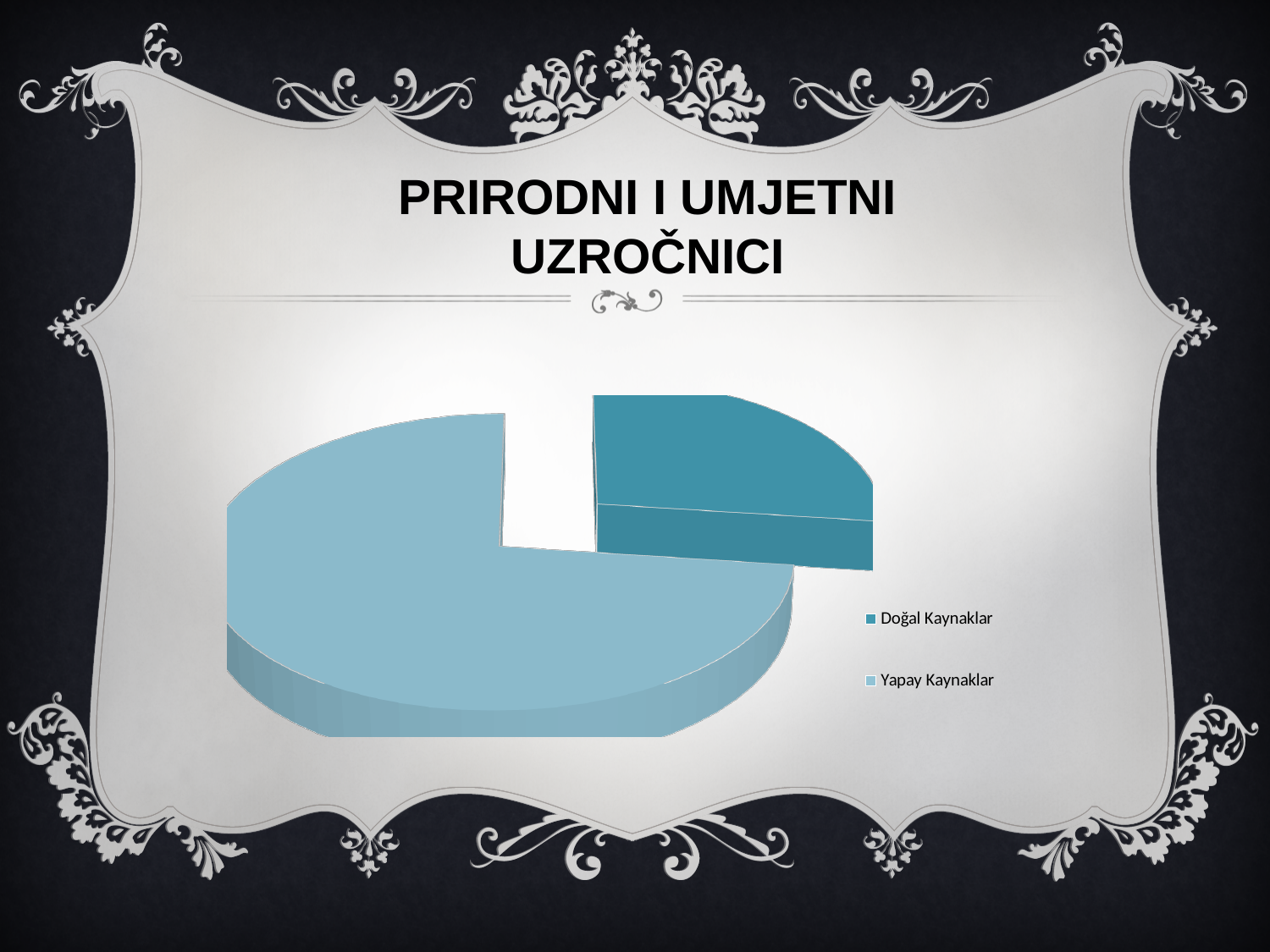
What kind of chart is shown on the slide? pie chart Which slice is larger in the pie chart, Doğal Kaynaklar or Yapay Kaynaklar? Yapay Kaynaklar Which category has the smallest slice in the pie chart? Doğal Kaynaklar How many slices does the pie chart have? 2 Which legend entry is listed first in the pie chart's legend? Doğal Kaynaklar How many entries does the legend of the pie chart list? 2 Which category is shown in the darker teal colour in the pie chart? Doğal Kaynaklar Which category has the largest slice in the pie chart? Yapay Kaynaklar